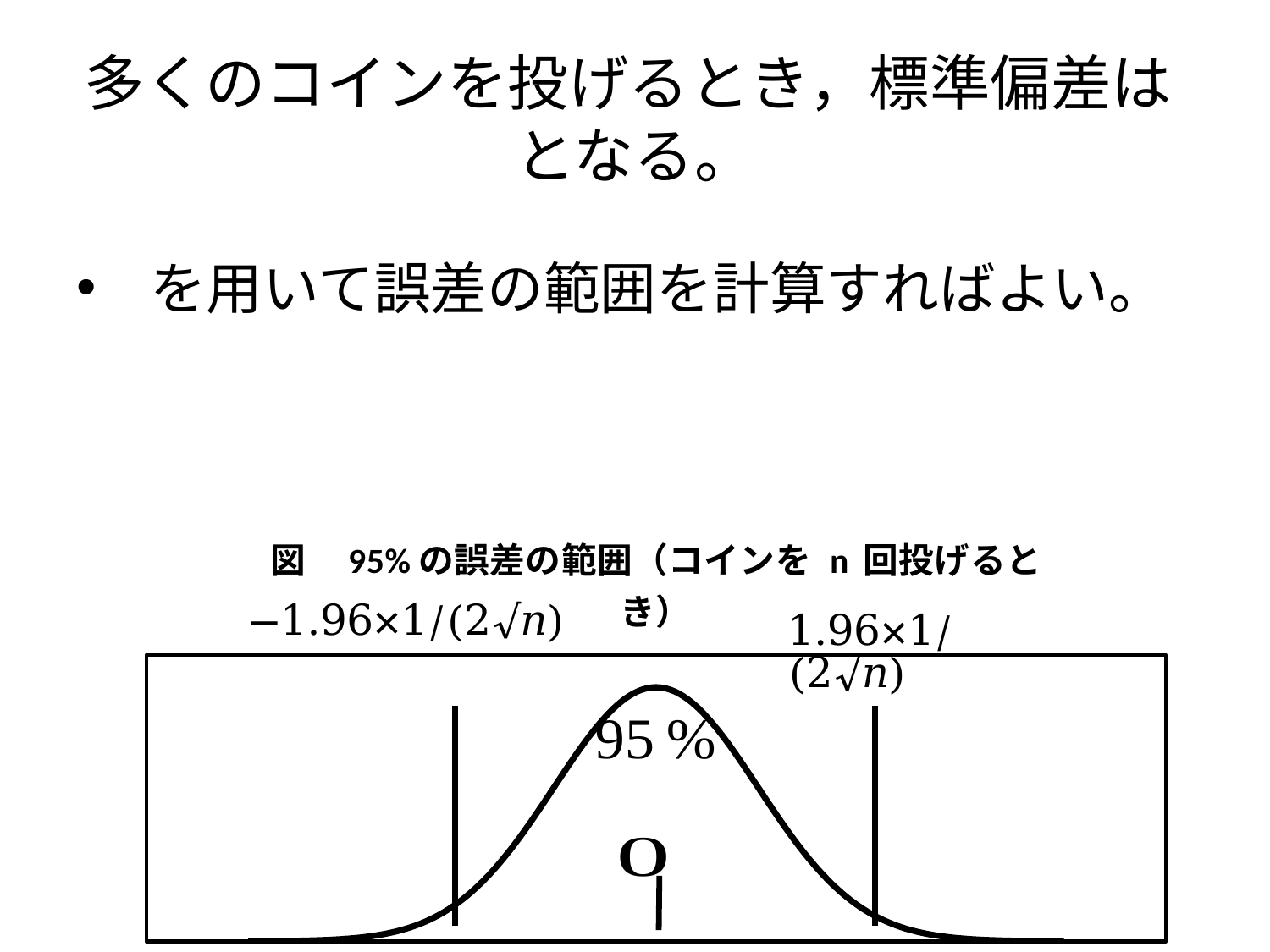
What kind of chart is shown on the slide? line chart What percentage is printed inside the central region of the curve between the two vertical lines? 95% What colour is the curve drawn in? black What label is printed at the right vertical boundary line of the curve? 1.96×1/(2√n) Does the curve rise or fall as it moves from the left edge toward the centre O? rise What label is printed at the left vertical boundary line of the curve? −1.96×1/(2√n) How many vertical boundary lines are drawn on the curve to mark the 95% range? 2 Does the curve rise or fall as it moves from the centre O toward the right edge? fall What is the title of the figure? 図 95%の誤差の範囲（コインを n 回投げるとき） What label marks the centre of the curve on the horizontal axis? O